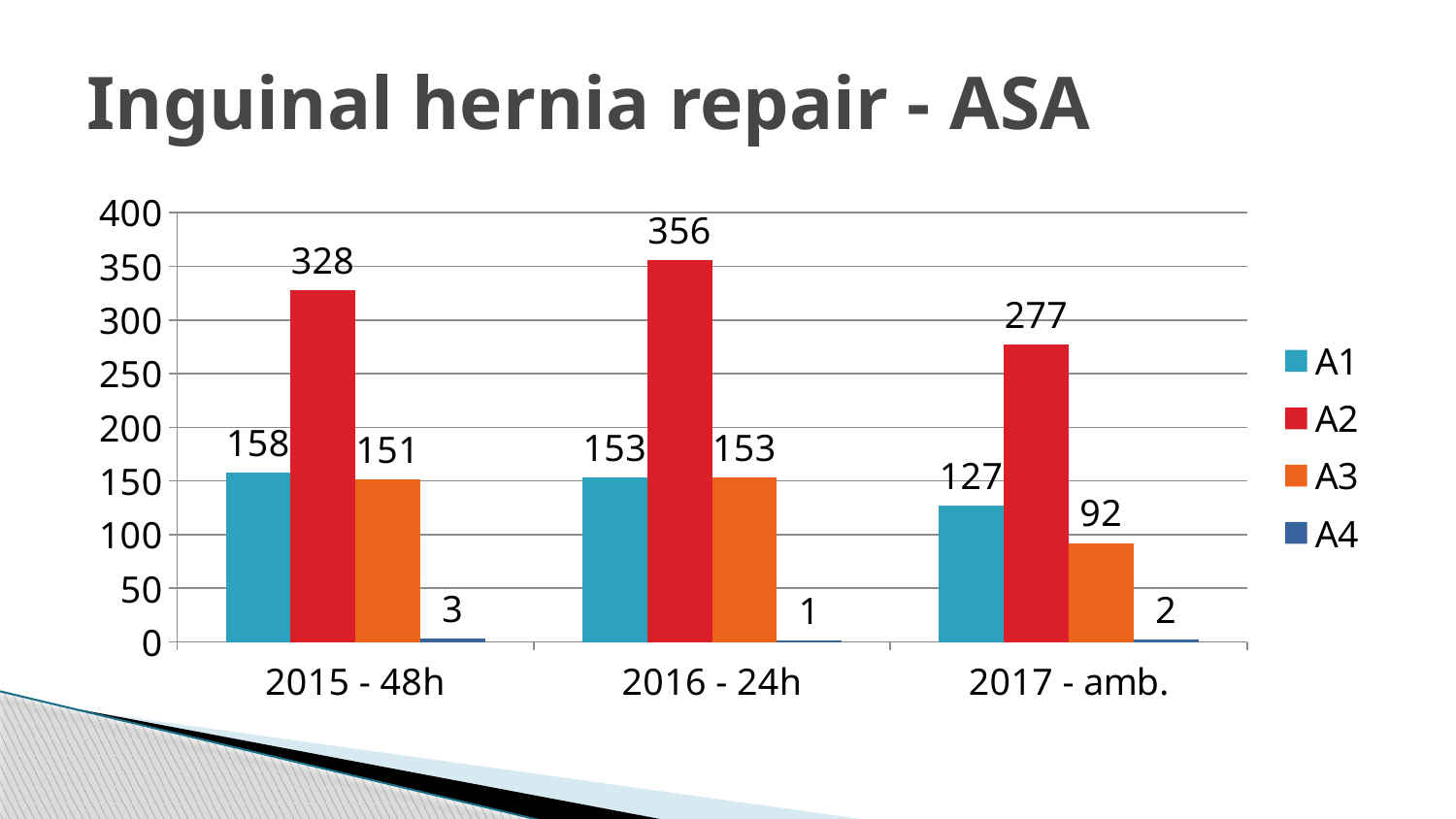
How many categories are shown on the x axis? 3 What is the difference between the A2 values for 2016 - 24h and 2017 - amb.? 79 What is the value of A4 for 2015 - 48h? 3 What is the value of A2 for 2016 - 24h? 356 What is the value of A3 for 2017 - amb.? 92 Which is larger, A1 for 2015 - 48h or A1 for 2016 - 24h? A1 for 2015 - 48h Does the A3 value rise or fall from 2016 - 24h to 2017 - amb.? Fall What kind of chart is shown on the slide? Bar chart How many series does the legend list? 4 Which category has the lowest A1 value? 2017 - amb. Which category has the highest A2 value? 2016 - 24h What is the title of the slide? Inguinal hernia repair - ASA